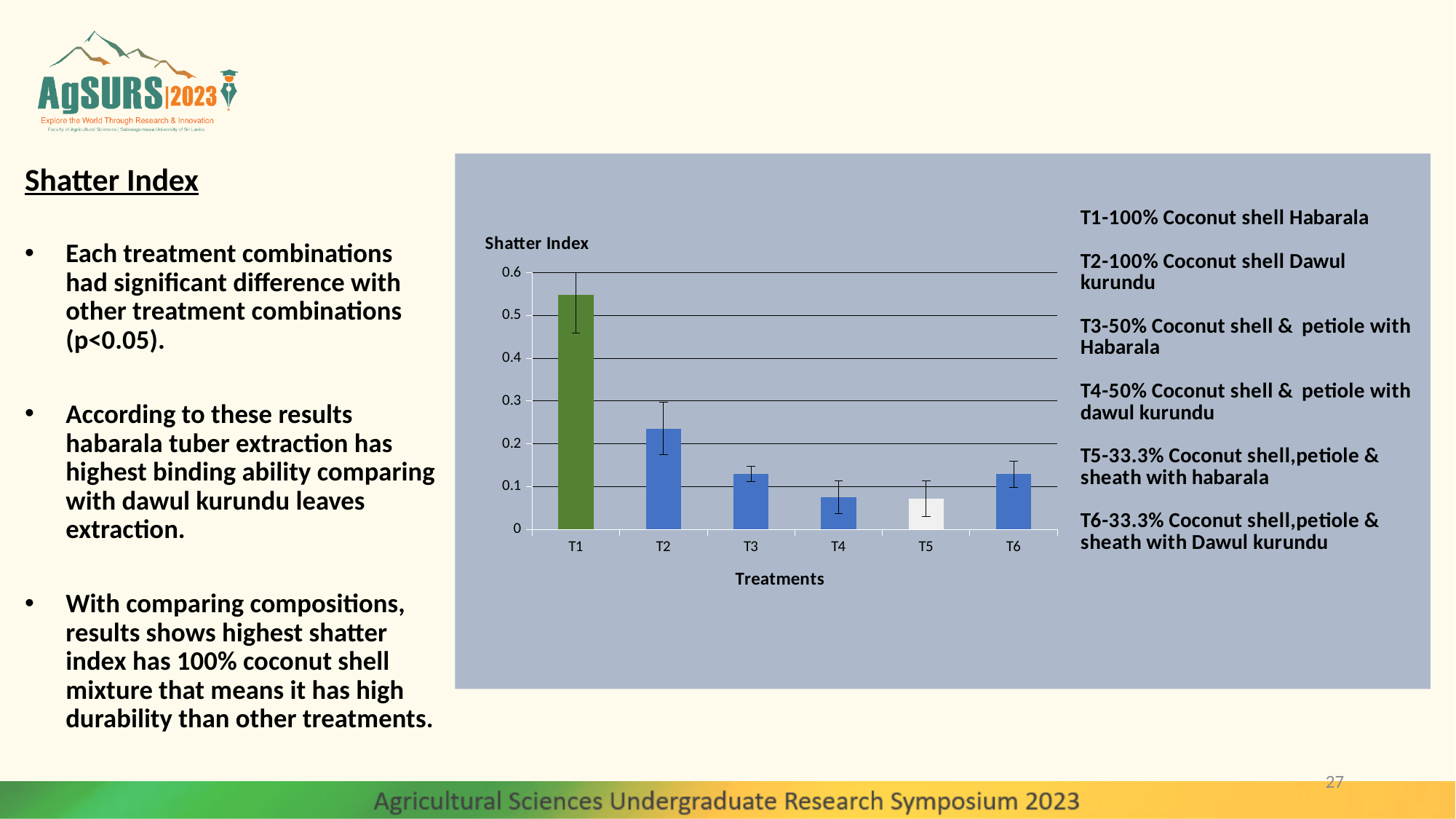
Which treatment has the highest shatter index? T1 Is the shatter index for T3 greater or less than 0.1? greater What is the title of the chart? Shatter Index How many treatments are plotted on the x axis of the Shatter Index chart? 6 Is the shatter index for T1 greater or less than 0.5? greater Is the shatter index for T2 greater or less than 0.3? less What is the label of the x axis of the chart? Treatments Which has a higher shatter index, T1 or T2? T1 Which has a higher shatter index, T2 or T3? T2 What kind of chart is shown on the slide? bar chart